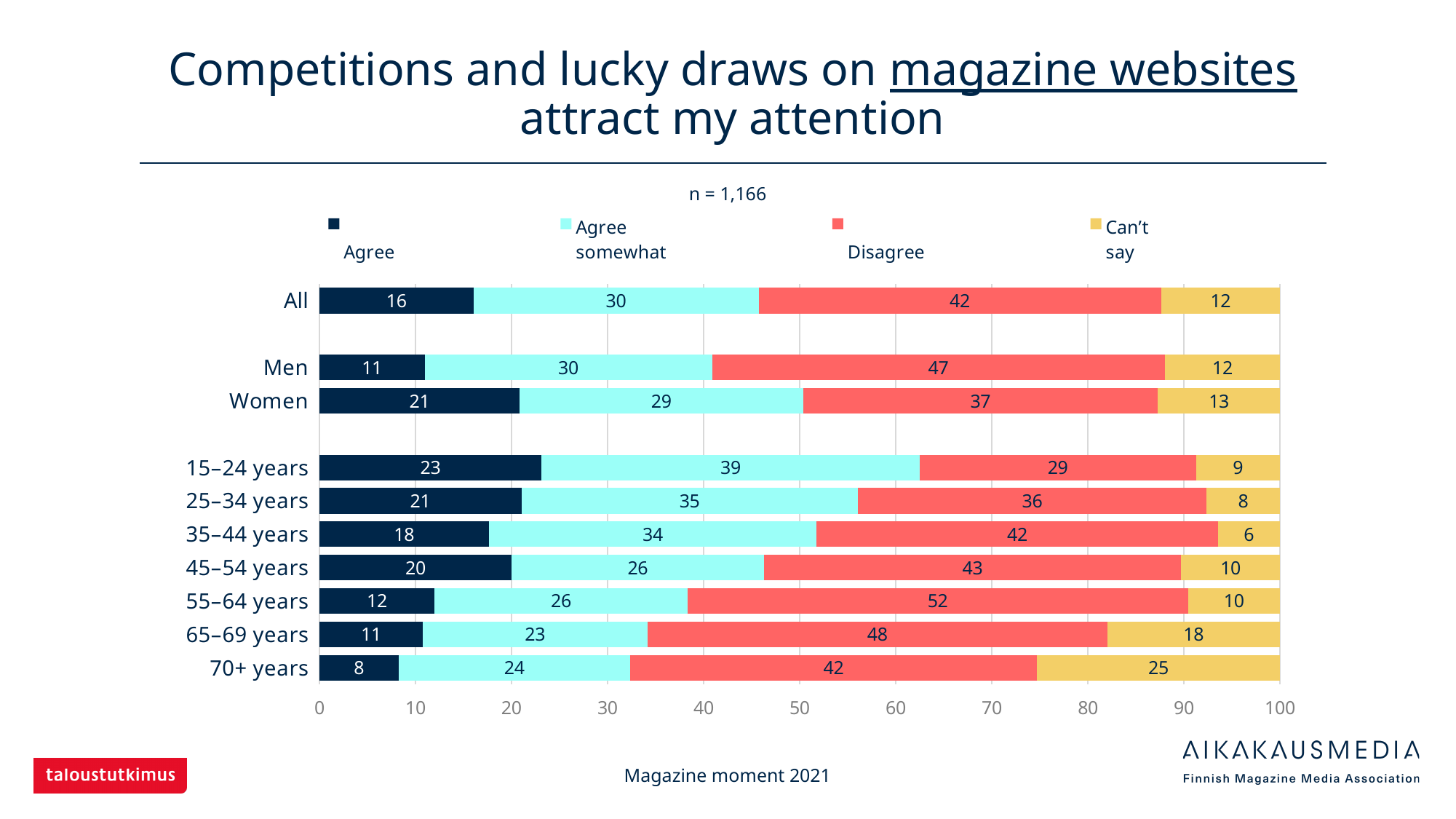
Which has a larger 'Agree somewhat' value, 15–24 years or 45–54 years? 15–24 years What is the 'Can't say' value for the 70+ years group? 25 What is the 'Disagree' value for the 55–64 years group? 52 What is the 'Agree' value for Women? 21 What sample size (n) is shown on the slide? n = 1,166 What kind of chart is shown on the slide? Stacked bar chart What is the difference between the 'Disagree' values for Men and Women? 10 Which category has the lowest 'Can't say' value? 35–44 years How many categories are shown on the chart? 10 What is the total of the stacked bar for the 65–69 years group? 100 How many series does the legend list? 4 Which category has the highest 'Agree' value? 15–24 years